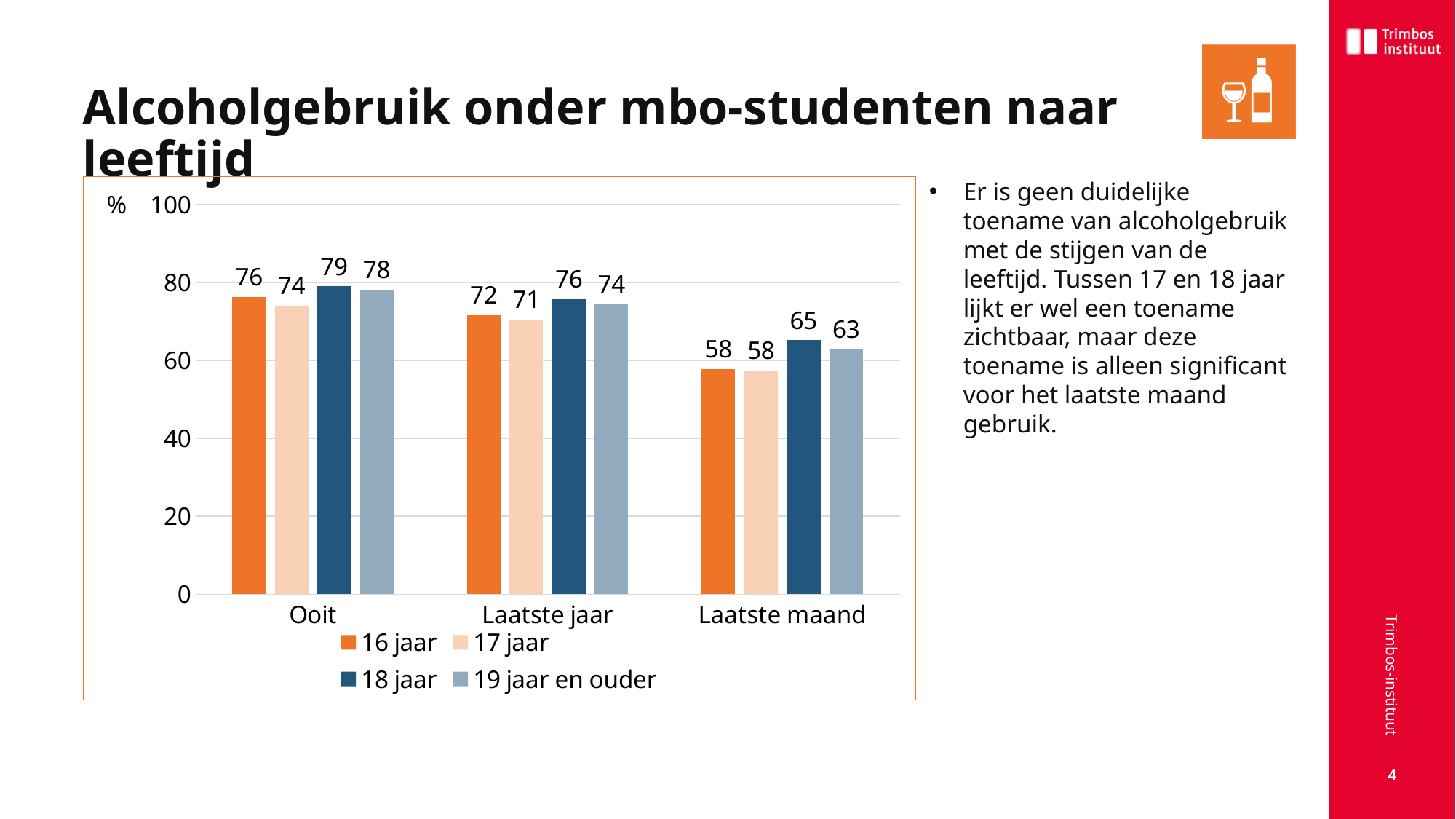
What is the value for 16 jaar in the Laatste maand category? 58 Which age group has the highest value in the Laatste maand category? 18 jaar How many categories are shown on the x axis? 3 Which age group has the lowest value in the Laatste jaar category? 17 jaar Do the values for 18 jaar rise or fall from Ooit to Laatste maand? fall What kind of chart is shown on the slide? bar chart How many series does the legend list? 4 Which is larger in the Ooit category: the value for 16 jaar or the value for 17 jaar? 16 jaar Is the value for 19 jaar en ouder in the Laatste maand category greater or less than 60? greater What is the value for 19 jaar en ouder in the Laatste jaar category? 74 What is the difference between the 18 jaar and 16 jaar values in the Laatste maand category? 7 What is the value for 18 jaar in the Ooit category? 79